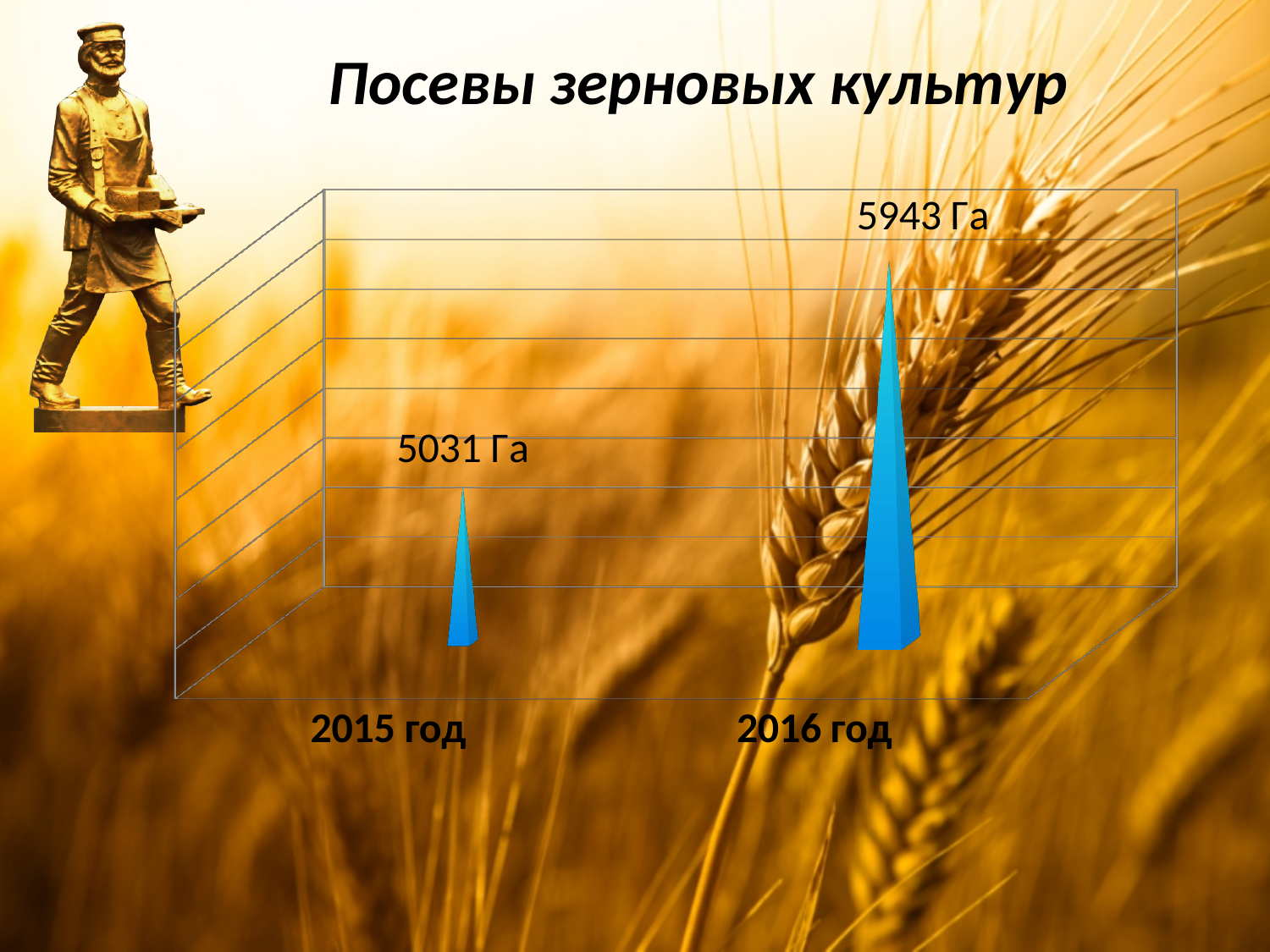
Which year has the lowest value? 2015 год What is the difference between the values for 2016 год and 2015 год? 912 Га What colour are the bars on the chart? Blue What kind of chart is shown on the slide? Bar chart What is the title of the slide? Посевы зерновых культур Which is larger, the value for 2015 год or for 2016 год? 2016 год What is the value for 2015 год? 5031 Га How many categories are shown on the chart? 2 Which year has the highest value? 2016 год Do the values rise or fall from 2015 год to 2016 год? Rise What is the value for 2016 год? 5943 Га